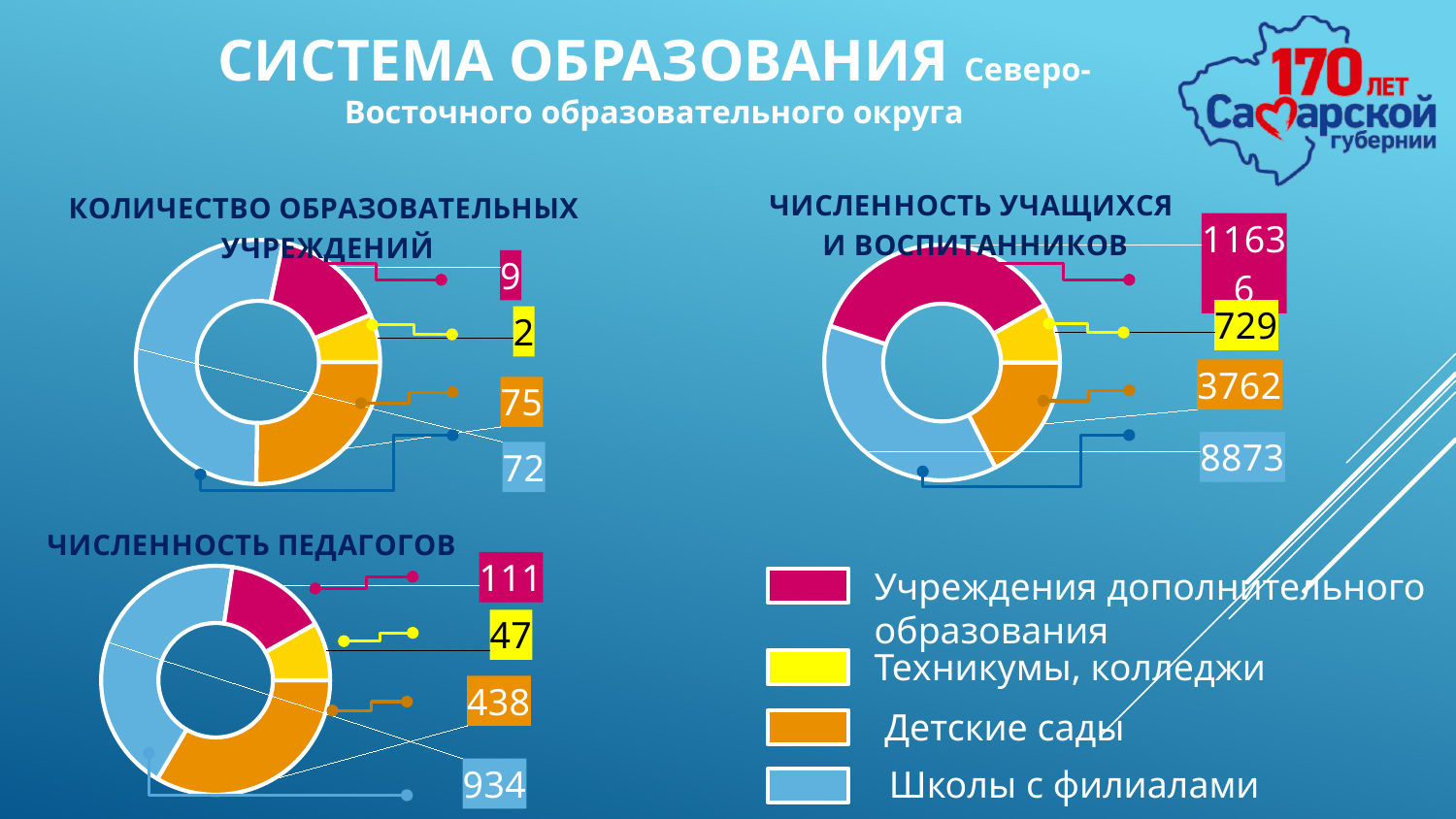
In the chart 'Численность педагогов', which is larger: Учреждения дополнительного образования or Техникумы, колледжи? Учреждения дополнительного образования In the chart 'Численность учащихся и воспитанников', which category has the lowest value? Техникумы, колледжи In the chart 'Количество образовательных учреждений', what is the value for Детские сады? 75 In the chart 'Численность учащихся и воспитанников', what is the value for Детские сады? 3762 In the chart 'Численность педагогов', what is the total of all four categories? 1530 What type of chart is used for 'Численность педагогов'? Pie (donut) chart In the chart 'Численность педагогов', what is the value for Школы с филиалами? 934 In the chart 'Численность педагогов', which category has the highest value? Школы с филиалами In the chart 'Количество образовательных учреждений', what is the value for Техникумы, колледжи? 2 In the chart 'Количество образовательных учреждений', which category has the lowest value? Техникумы, колледжи In the chart 'Численность учащихся и воспитанников', what is the value for Школы с филиалами? 8873 In the chart 'Количество образовательных учреждений', what is the difference between Детские сады and Школы с филиалами? 3